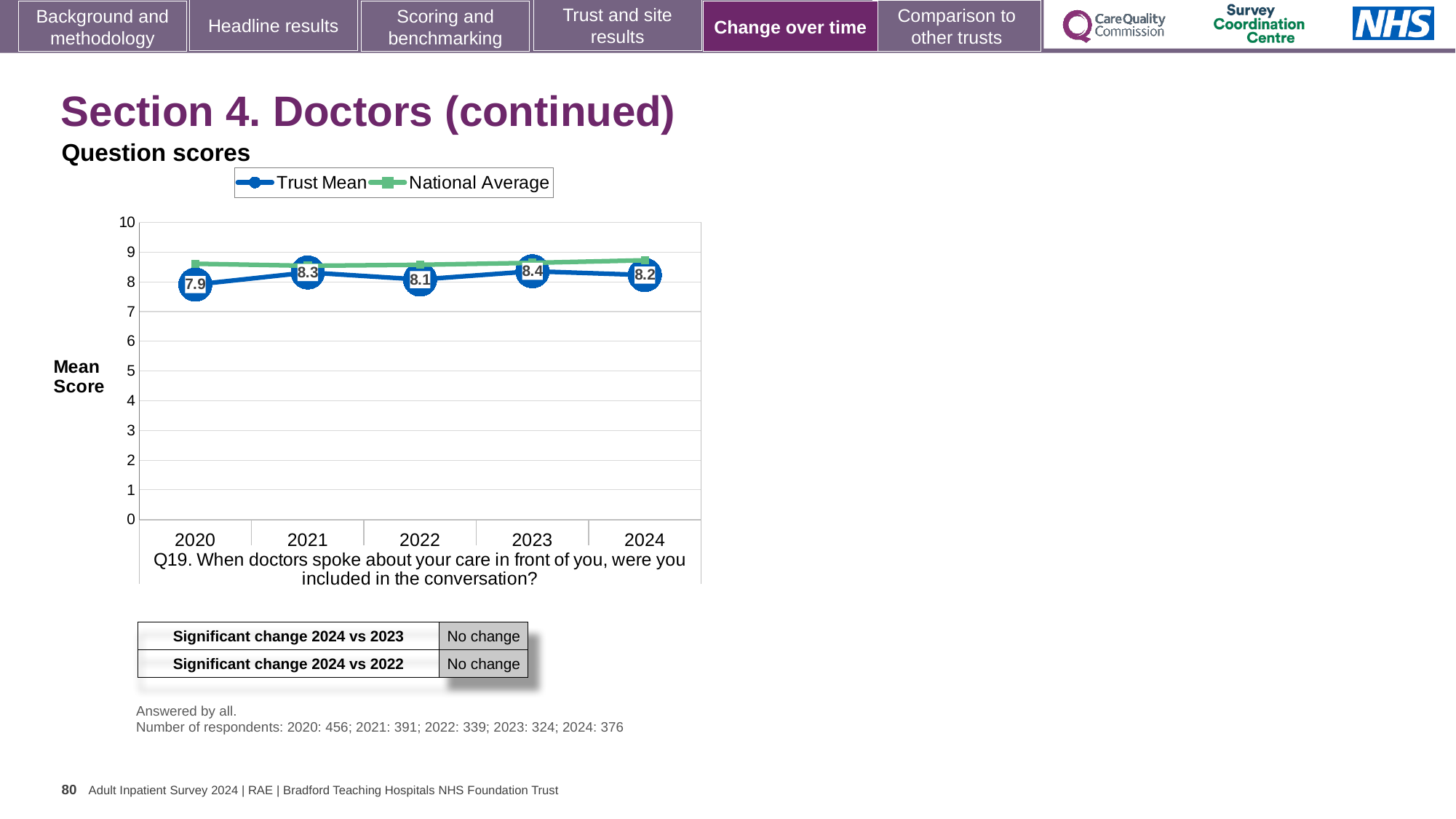
What is the difference between the Trust Mean scores for 2023 and 2020? 0.5 What kind of chart is shown? Line chart How many years are shown on the x axis? 5 In which year is the Trust Mean score highest? 2023 What is the Trust Mean score for 2024? 8.2 Is the National Average value for 2024 greater or less than 8? greater What is the Trust Mean score for 2023? 8.4 How many series does the legend list? 2 Which year has the larger Trust Mean score, 2021 or 2022? 2021 What is the Trust Mean score for 2020? 7.9 In which year is the Trust Mean score lowest? 2020 What is the label on the y axis? Mean Score